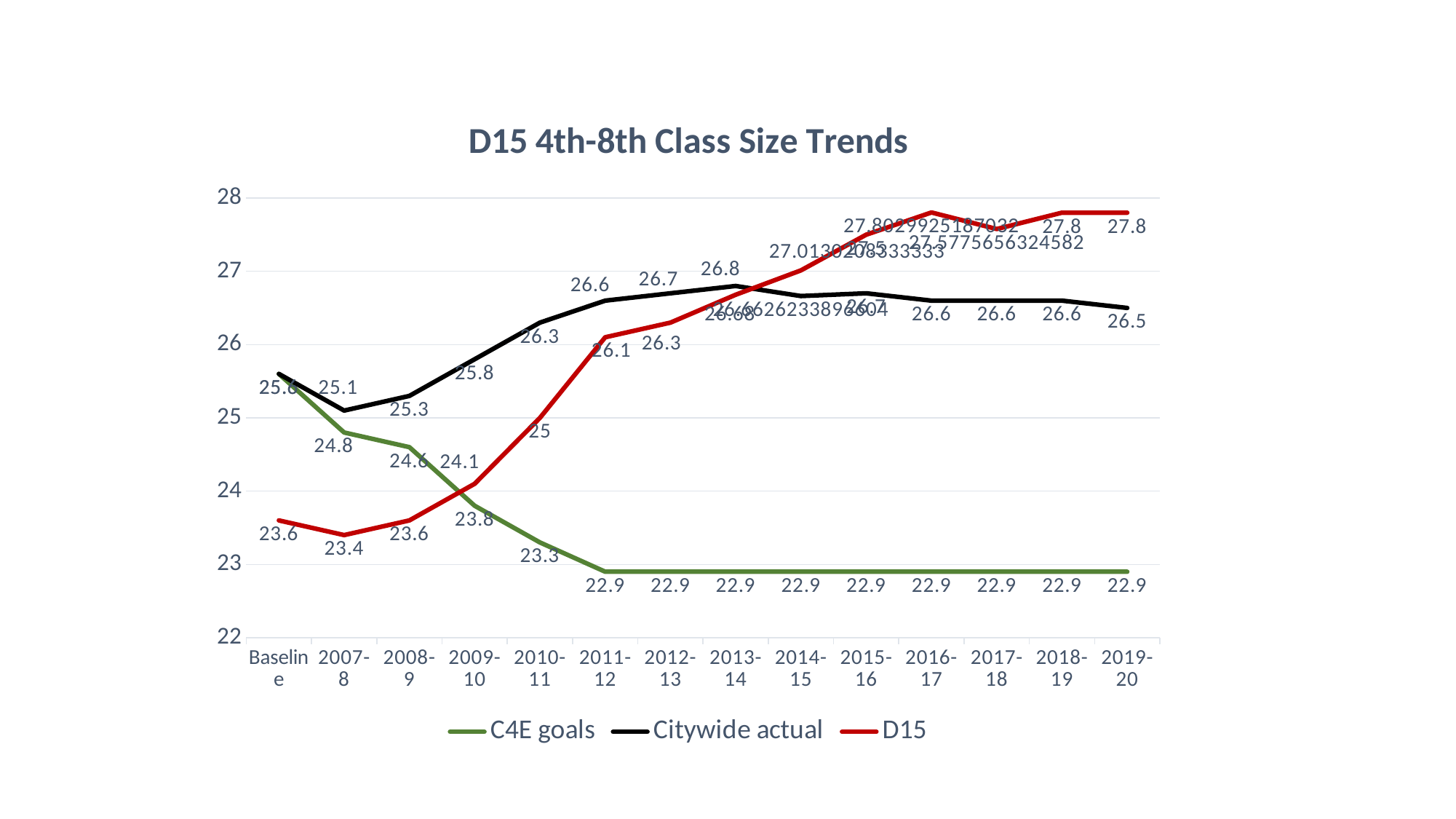
What is the D15 value at Baseline? 23.6 How many series does the legend list? 3 What is the D15 value for 2010-11? 25 What is the title of the chart? D15 4th-8th Class Size Trends In 2019-20, which is larger: the D15 value or the Citywide actual value? D15 Which category has the lowest D15 value? 2007-8 What is the Citywide actual value for 2019-20? 26.5 What is the C4E goals value for 2007-8? 24.8 What type of chart is shown on the slide? line chart How many categories are shown on the x axis? 14 Is the D15 value for 2015-16 greater or less than 27? greater What is the difference between the Citywide actual value and the C4E goals value in 2019-20? 3.6